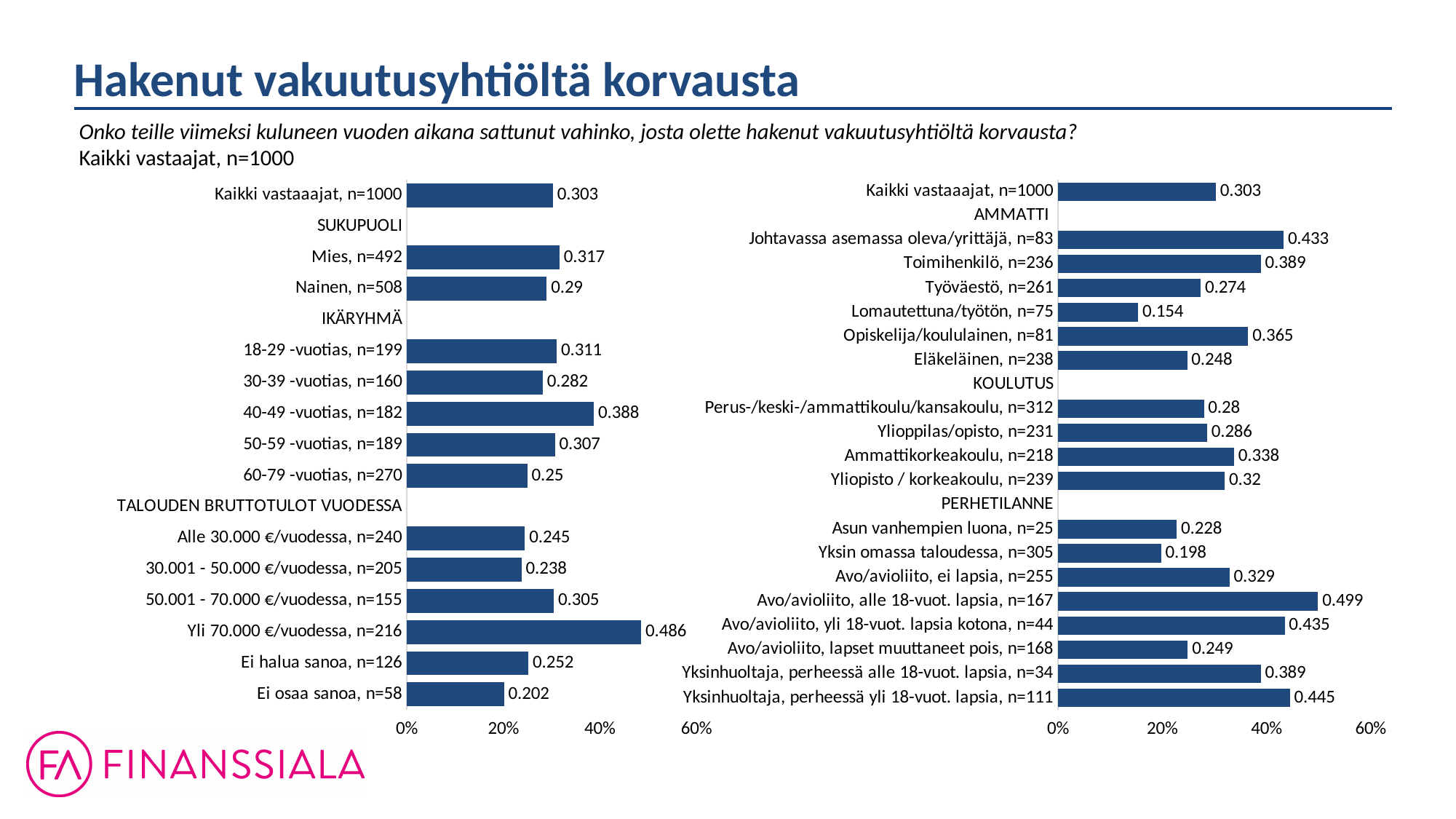
In the left chart, what is the value for 40-49 -vuotias, n=182? 0.388 In the right chart, which category has the highest value? Avo/avioliito, alle 18-vuot. lapsia, n=167 In the right chart, what is the value for Ammattikorkeakoulu, n=218? 0.338 What type of chart is shown on the left of the slide? bar chart In the left chart, which category has the highest value? Yli 70.000 €/vuodessa, n=216 In the right chart, which category has the lowest value? Lomautettuna/työtön, n=75 In the right chart, what is the value for Lomautettuna/työtön, n=75? 0.154 In the left chart, what is the difference between the values for Mies, n=492 and Nainen, n=508? 0.027 In the right chart, is the value for Yksinhuoltaja, perheessä yli 18-vuot. lapsia, n=111 greater or less than 40%? greater In the right chart, which is larger: the value for Toimihenkilö, n=236 or Työväestö, n=261? Toimihenkilö, n=236 In the left chart, which category has the lowest value? Ei osaa sanoa, n=58 In the left chart, what is the value for Mies, n=492? 0.317